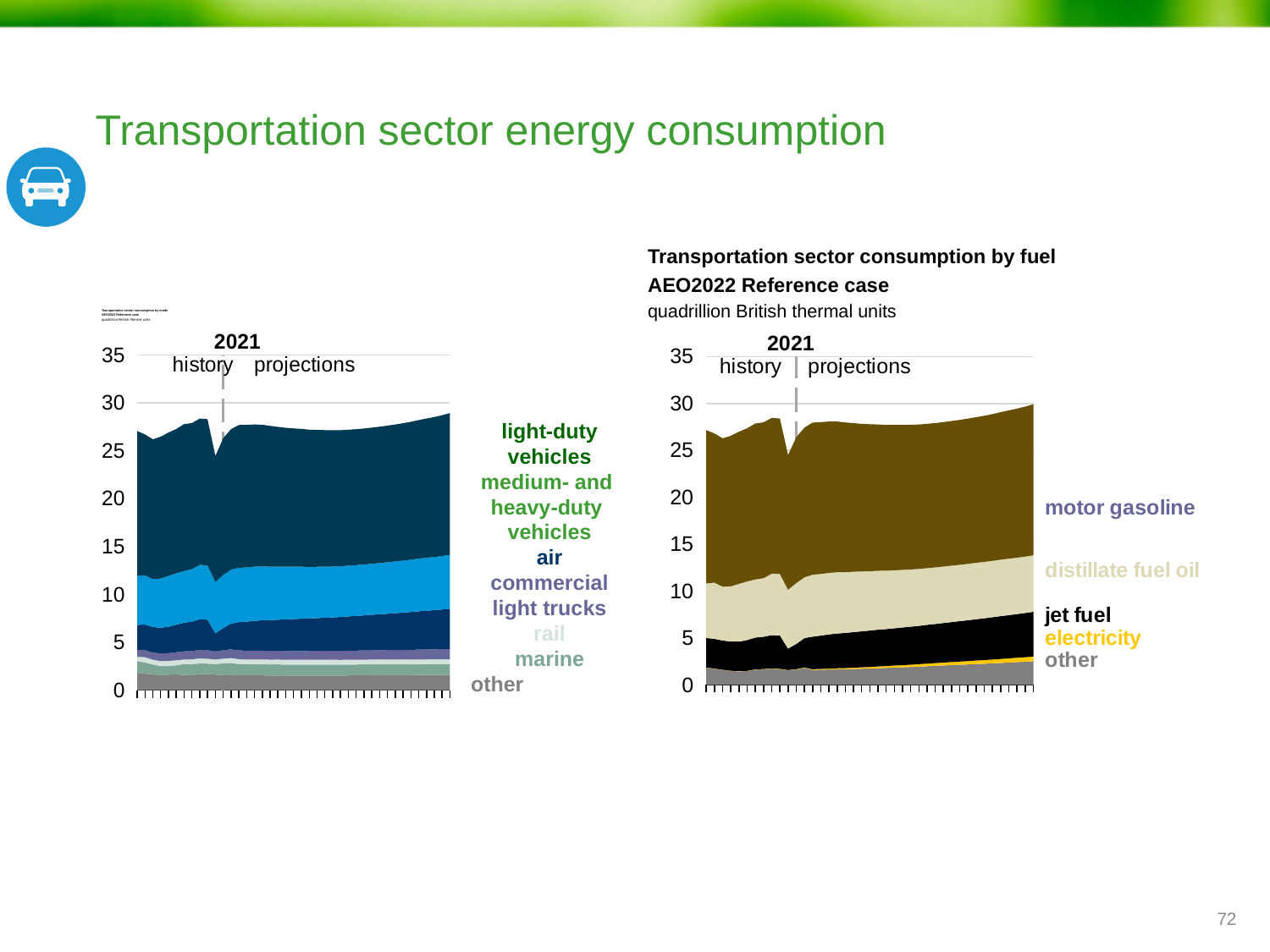
In the left-hand chart, which mode accounts for the largest share of consumption? light-duty vehicles In the right-hand chart, 'Transportation sector consumption by fuel', does total consumption rise or fall over the projection period? rise In the right-hand chart, 'Transportation sector consumption by fuel', is the total consumption at the start of the history period greater or less than 30? less In the right-hand chart, 'Transportation sector consumption by fuel', which year separates history from projections? 2021 In the right-hand chart, 'Transportation sector consumption by fuel', is the total consumption at the end of the projection period greater or less than 25? greater In the right-hand chart, 'Transportation sector consumption by fuel', which fuel accounts for the largest share of consumption? motor gasoline What kind of chart is the left-hand chart on the slide? stacked area chart In the right-hand chart, 'Transportation sector consumption by fuel', which fuel accounts for the smallest share of consumption? electricity What unit of measurement is used in the right-hand chart, 'Transportation sector consumption by fuel'? quadrillion British thermal units In the right-hand chart, 'Transportation sector consumption by fuel', how many fuel series are labelled? 5 What kind of chart is the right-hand chart, 'Transportation sector consumption by fuel'? stacked area chart In the left-hand chart, how many mode series are labelled? 7